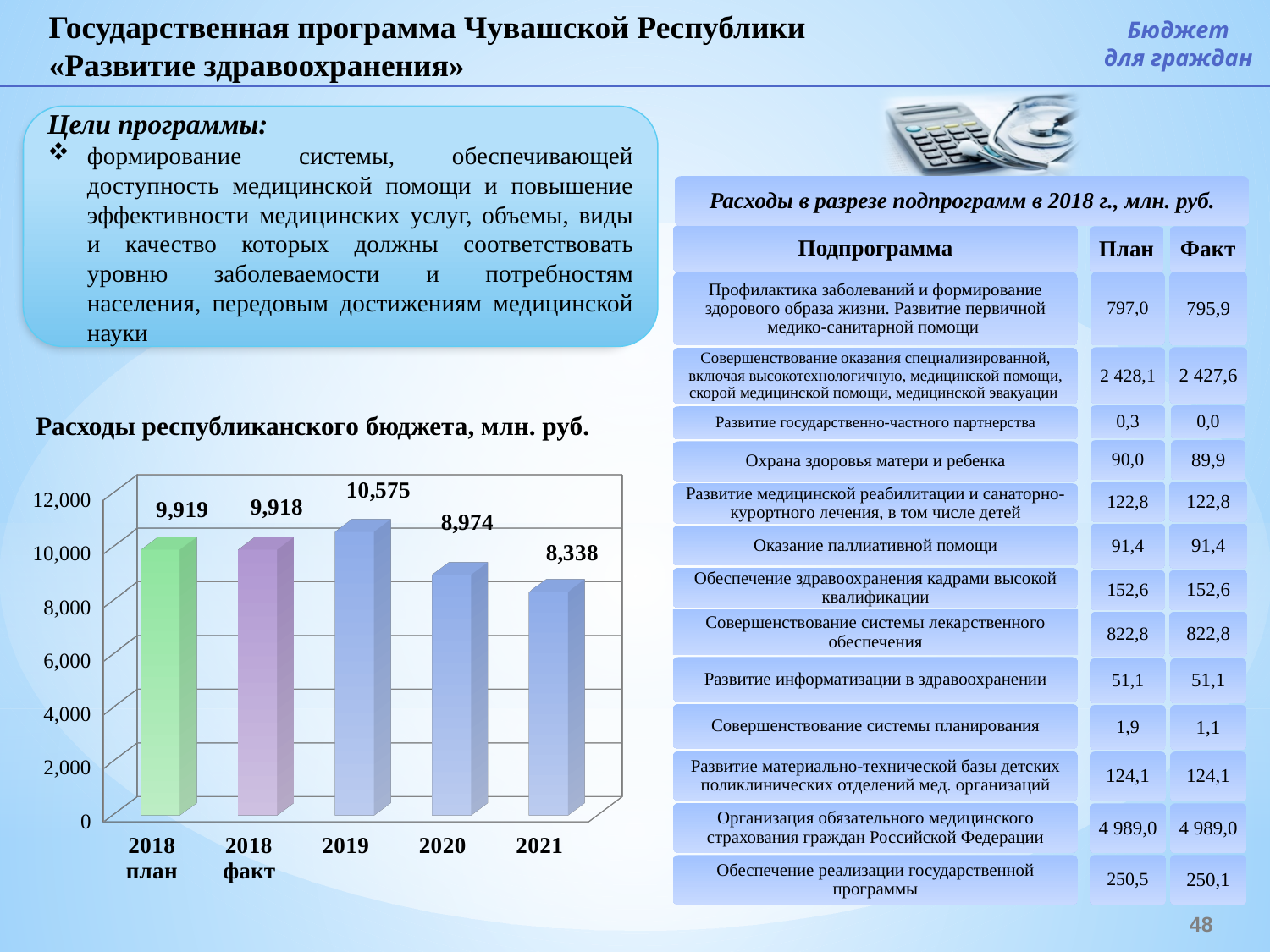
What is the value for 2021 in the chart? 8,338 Which is larger in the chart: the value for 2019 or the value for 2020? 2019 How many bars are shown in the chart? 5 What is the value for '2018 план' in the chart? 9,919 Which category has the highest value in the chart? 2019 Do the values rise or fall from 2019 to 2021 in the chart? Fall What is the value for '2018 факт' in the chart? 9,918 What is the difference between the values for 2019 and 2020 in the chart? 1,601 What is the value for 2019 in the chart 'Расходы республиканского бюджета, млн. руб.'? 10,575 What kind of chart is shown on the slide? Bar chart What is the difference between the values for 2020 and 2021 in the chart? 636 Which category has the lowest value in the chart? 2021